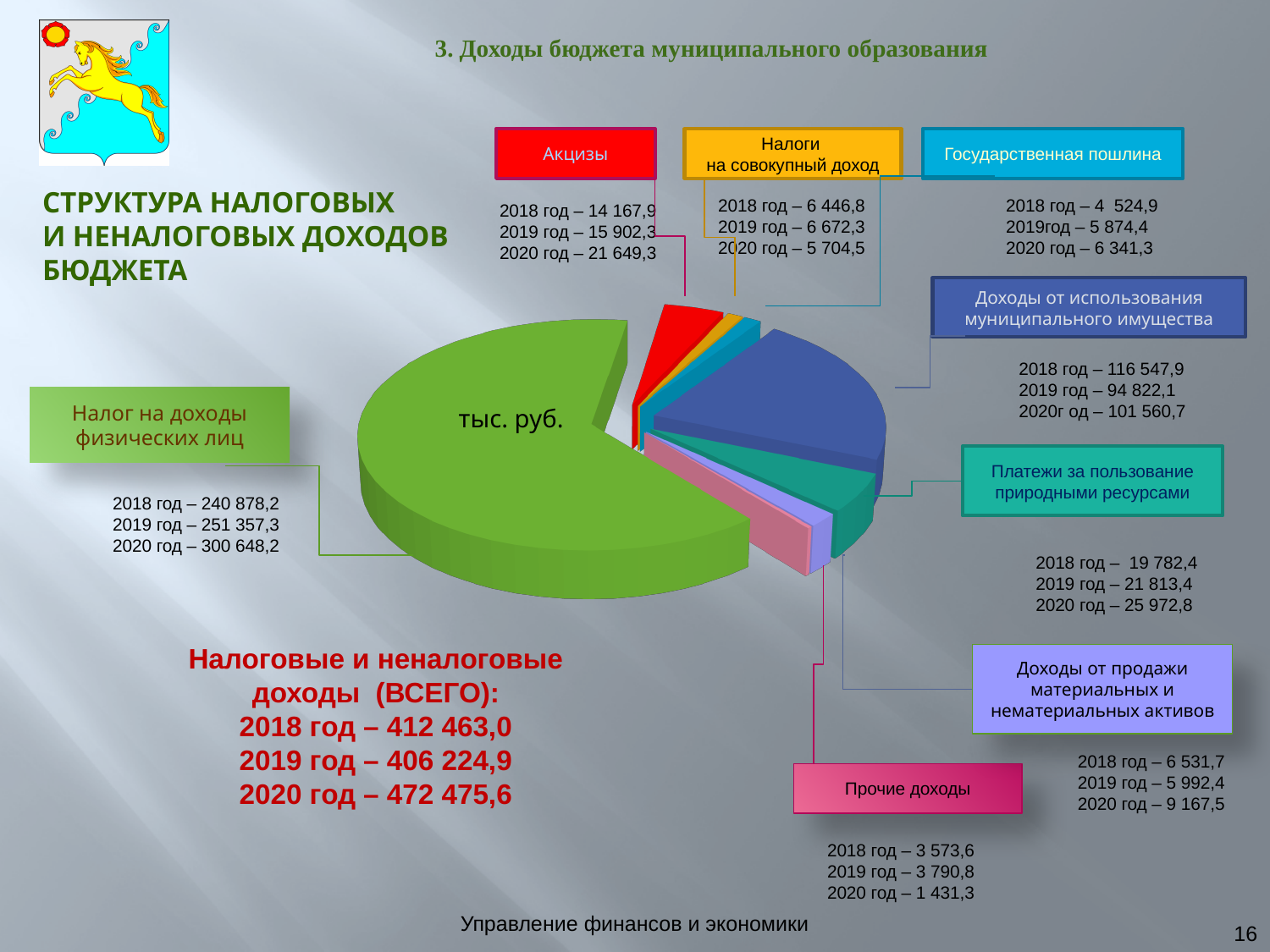
What is the total of Налоговые и неналоговые доходы (ВСЕГО) for 2020? 472 475,6 What is the value for Налог на доходы физических лиц in 2020? 300 648,2 Which category has the largest slice in the pie chart? Налог на доходы физических лиц What kind of chart is shown on the slide? pie chart By how much did Акцизы increase from 2019 to 2020? 5 747,0 How many slices does the pie chart have? 8 What is the value for Прочие доходы in 2020? 1 431,3 What is the value for Доходы от использования муниципального имущества in 2019? 94 822,1 What is the value for Государственная пошлина in 2018? 4 524,9 What unit is written in the centre of the pie chart? тыс. руб. What is the value for Акцизы in 2019? 15 902,3 Which is larger in 2020: Платежи за пользование природными ресурсами or Доходы от продажи материальных и нематериальных активов? Платежи за пользование природными ресурсами